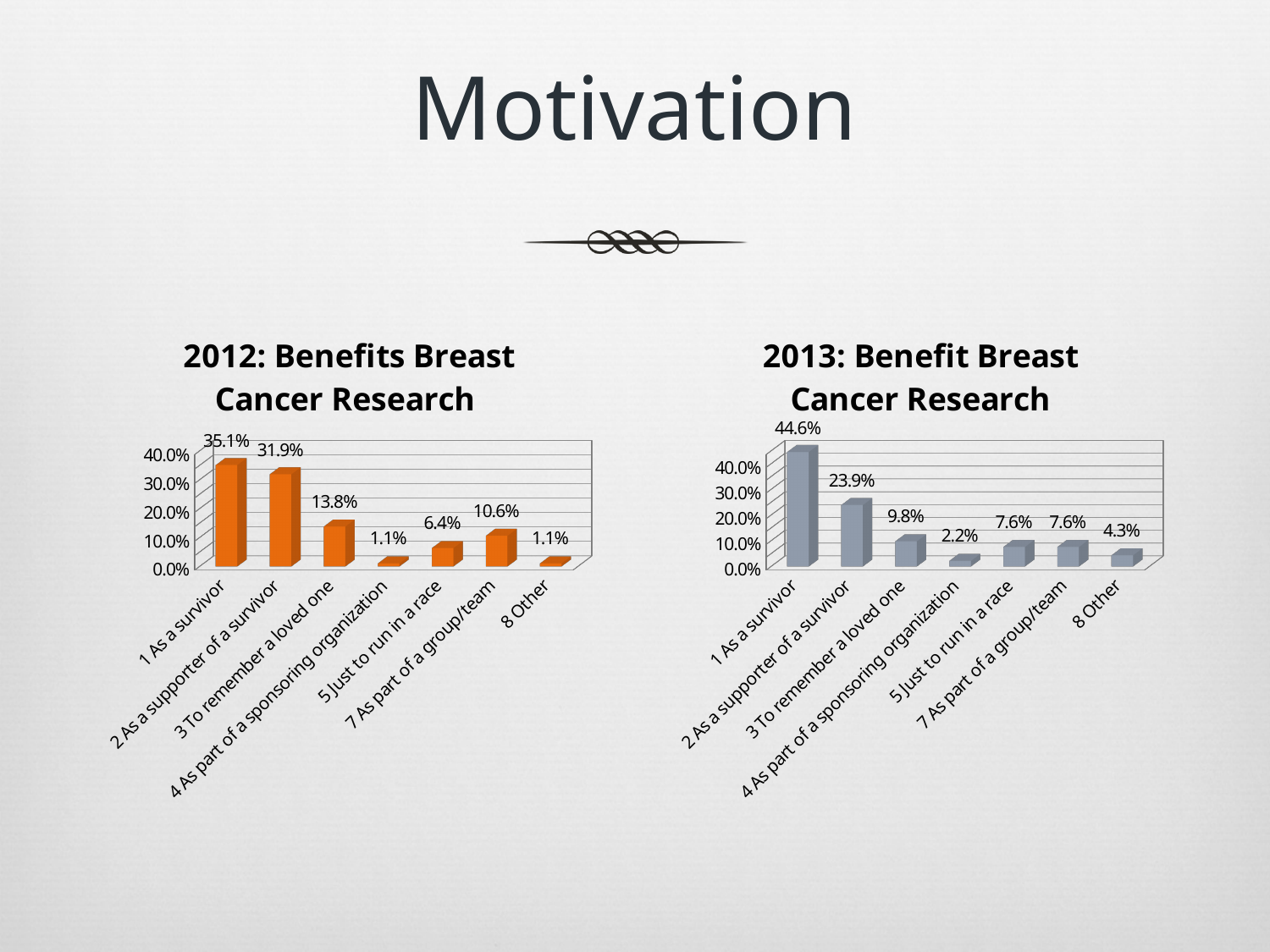
In the 2013: Benefit Breast Cancer Research chart, is the value for 1 As a survivor greater or less than 40.0%? greater In the 2013: Benefit Breast Cancer Research chart, what is the value for 8 Other? 4.3% What kind of chart is the 2013: Benefit Breast Cancer Research chart? bar chart In the 2013: Benefit Breast Cancer Research chart, what is the value for 2 As a supporter of a survivor? 23.9% In the 2012: Benefits Breast Cancer Research chart, what is the value for 1 As a survivor? 35.1% In the 2012: Benefits Breast Cancer Research chart, what is the difference between 1 As a survivor and 2 As a supporter of a survivor? 3.2% How many categories are shown in the 2012: Benefits Breast Cancer Research chart? 7 In the 2012: Benefits Breast Cancer Research chart, which category has the highest value? 1 As a survivor In the 2012: Benefits Breast Cancer Research chart, which is larger: 5 Just to run in a race or 7 As part of a group/team? 7 As part of a group/team What colour are the bars in the 2012: Benefits Breast Cancer Research chart? orange In the 2013: Benefit Breast Cancer Research chart, what is the difference between 1 As a survivor and 3 To remember a loved one? 34.8% In the 2013: Benefit Breast Cancer Research chart, which category has the lowest value? 4 As part of a sponsoring organization